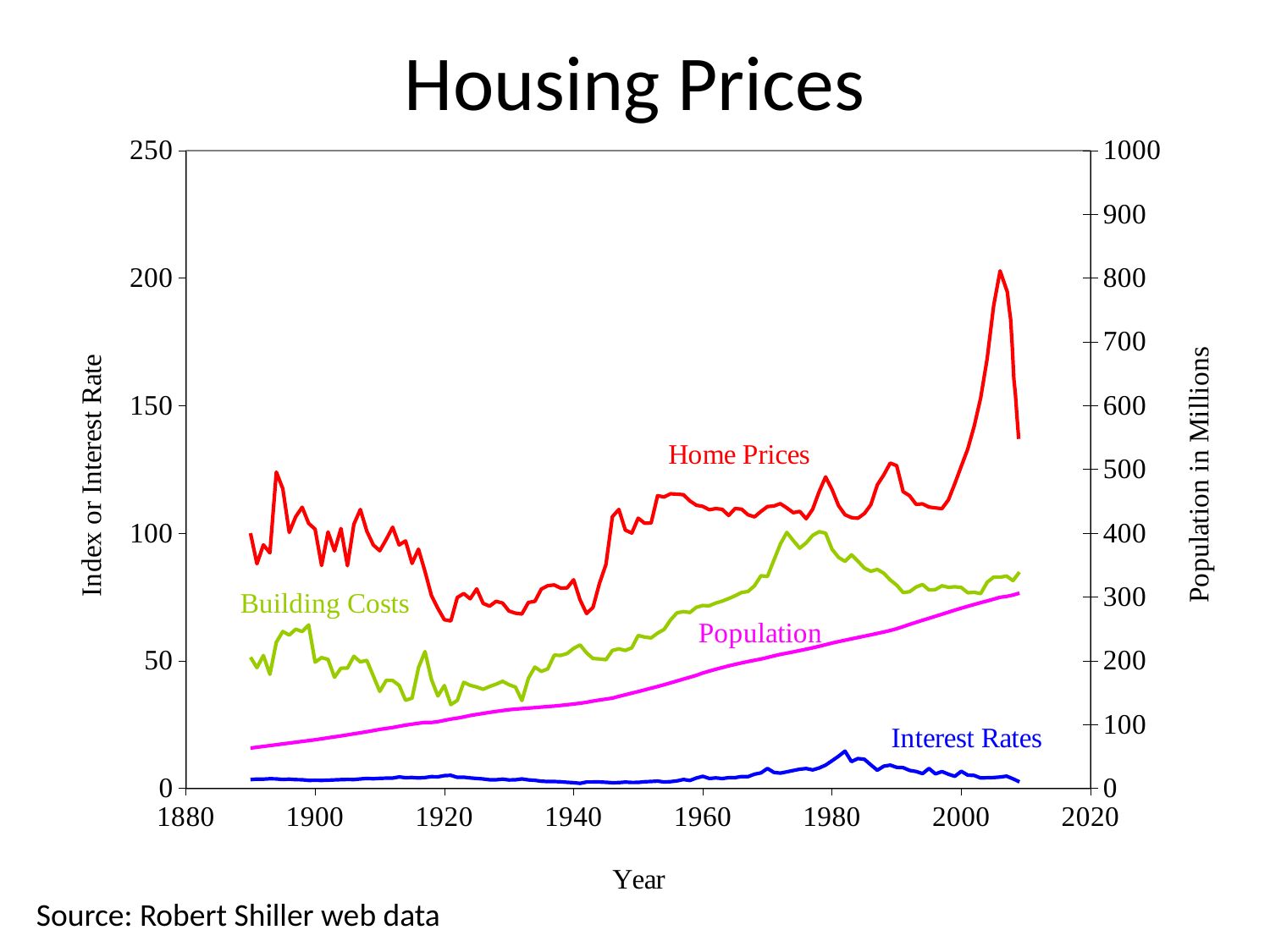
Is the Population value in 1890, read on the right axis, greater or less than 100? less Around the year 2000, which is higher: Home Prices or Building Costs? Home Prices What is the label of the right-hand vertical axis? Population in Millions Is the highest value of the Interest Rates series greater or less than 50? less Does the Population series rise or fall as the year increases? rise Is the value of Building Costs around 1921 greater or less than 50? less Which series has the lowest values across the whole chart? Interest Rates How many data series are plotted on the chart? 4 What kind of chart is shown on the slide? line chart What is the title of the chart? Housing Prices